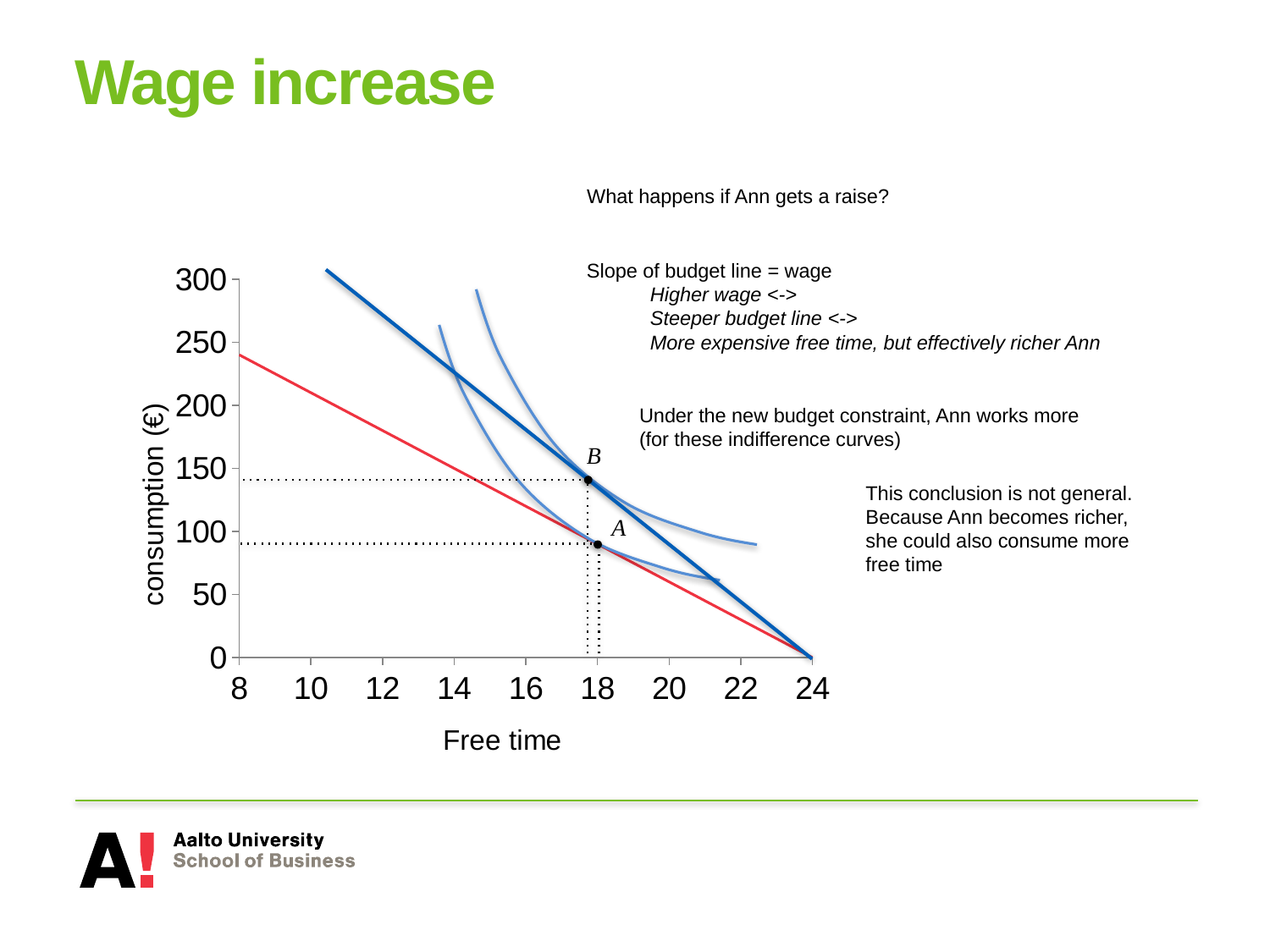
How much free time does point A correspond to on the chart? 18 What is the label of the vertical axis of the chart? consumption (€) What kind of chart is shown on the slide? line chart Is the consumption value at point B greater or less than 150? less Is the consumption value at point B greater or less than 100? greater Which point has the higher consumption, A or B? B Do the budget lines rise or fall as free time increases? fall At what value of free time do both budget lines reach zero consumption? 24 Is the consumption value at point A greater or less than 100? less What is the label of the horizontal axis of the chart? Free time Which budget line is steeper, the blue one or the red one? the blue one How many labelled points are marked on the chart? 2